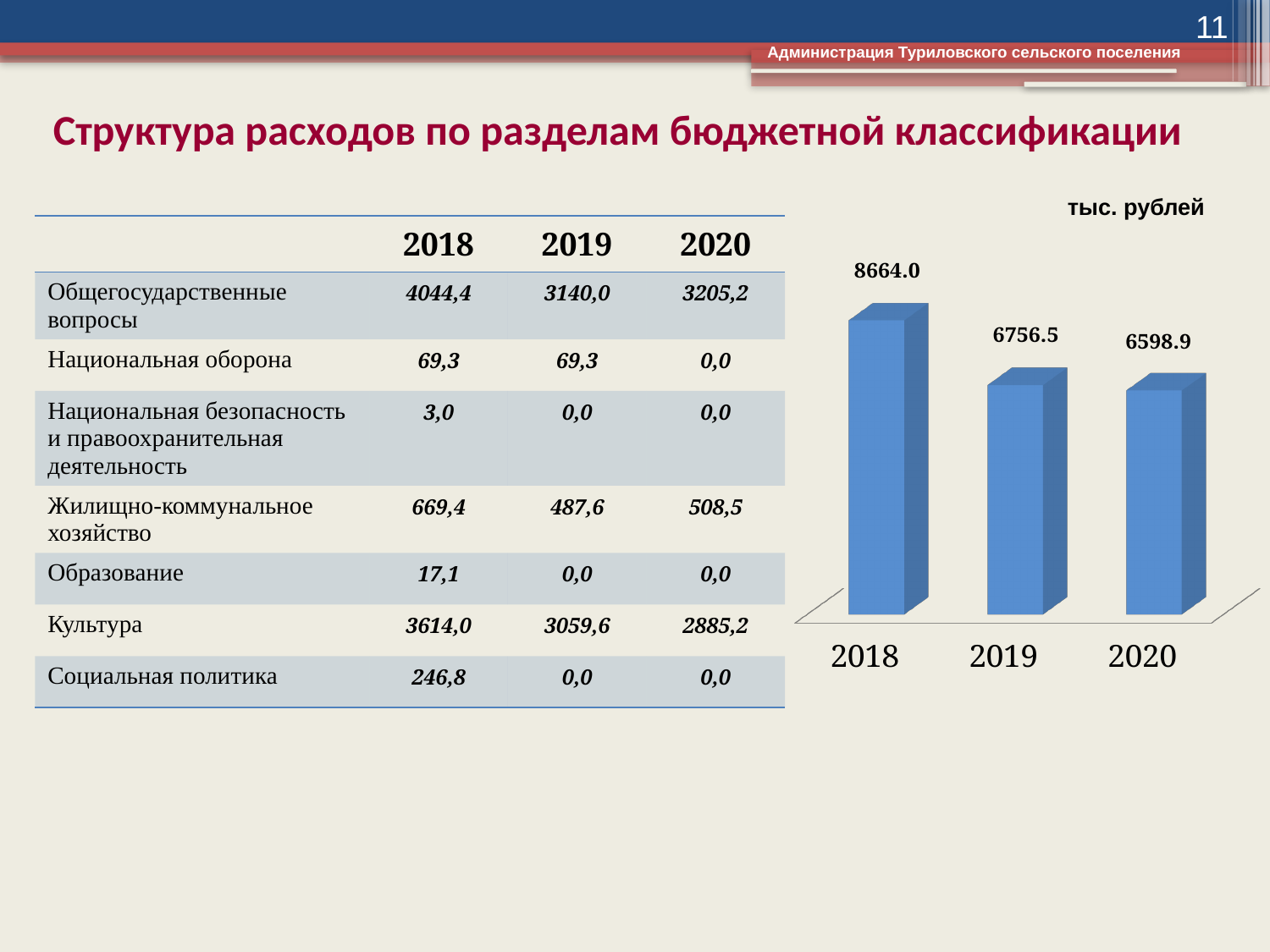
What is the difference between the 2019 and 2020 values in the bar chart? 157.6 Which year has the highest value in the bar chart? 2018 What is the difference between the 2018 and 2020 values in the bar chart? 2065.1 What is the value shown for 2019 in the bar chart? 6756.5 Which year has the lowest value in the bar chart? 2020 What is the value shown for 2020 in the bar chart? 6598.9 Do the values in the bar chart rise or fall from 2018 to 2020? fall What is the difference between the 2018 and 2019 values in the bar chart? 1907.5 How many bars are shown in the bar chart? 3 What type of chart is shown on the slide? bar chart In the bar chart, which is larger: the value for 2018 or the value for 2020? 2018 What is the value shown for 2018 in the bar chart? 8664.0